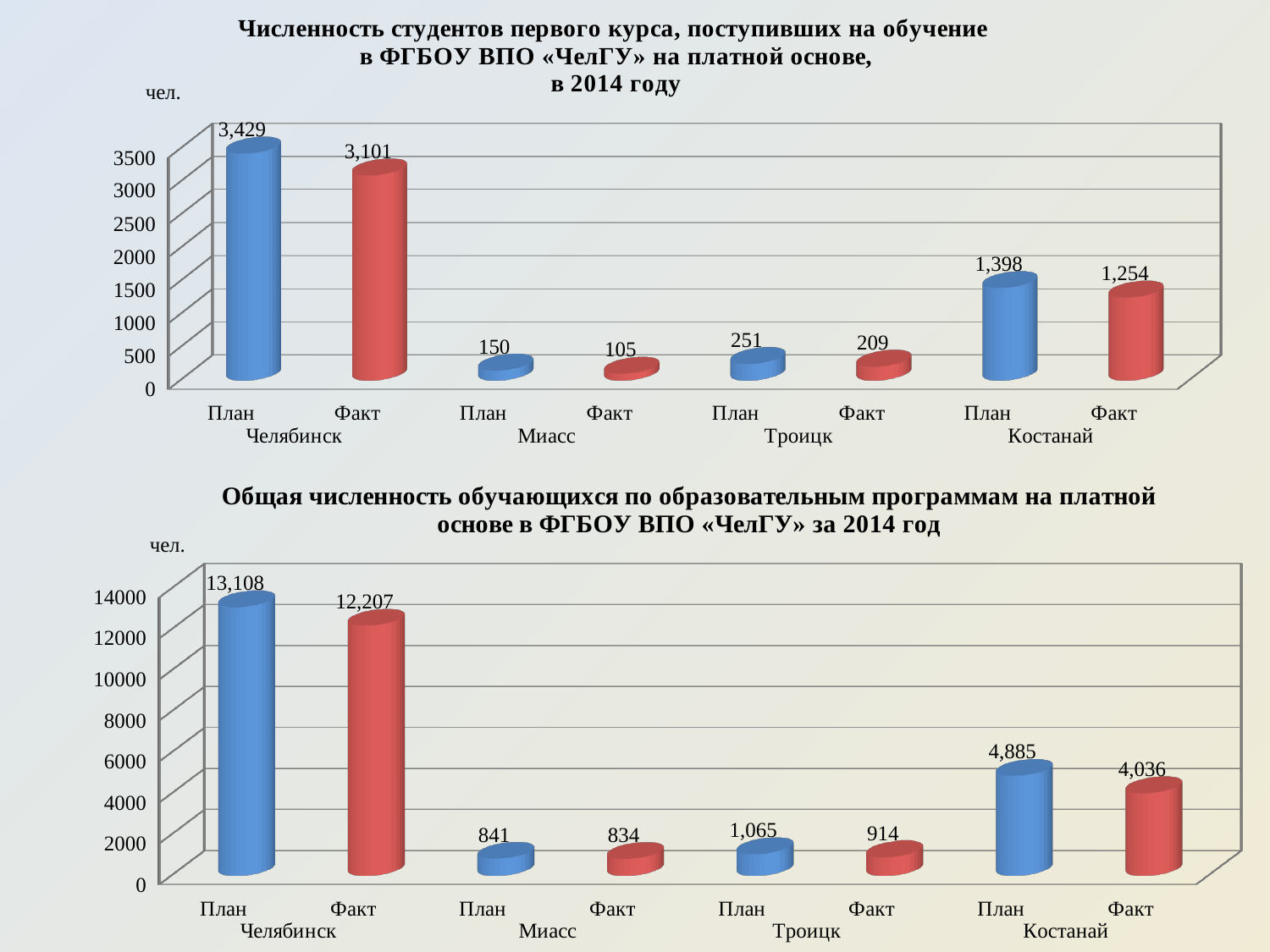
In the top chart, which is larger: План for Троицк or Факт for Троицк? План for Троицк In the bottom chart, what is the Факт value for Челябинск? 12,207 In the bottom chart, what is the План value for Костанай? 4,885 What unit is shown on the vertical axis of the bottom chart? чел. In the top chart, what is the Факт value for Миасс? 105 In the top chart, which bar has the lowest value? Факт Миасс In the bottom chart, what is the difference between План and Факт for Троицк? 151 In the top chart, what is the difference between План and Факт for Костанай? 144 What type of chart is the bottom chart? bar chart In the top chart, what is the План value for Челябинск? 3,429 How many bars are plotted in the top chart? 8 In the bottom chart, which bar has the highest value? План Челябинск